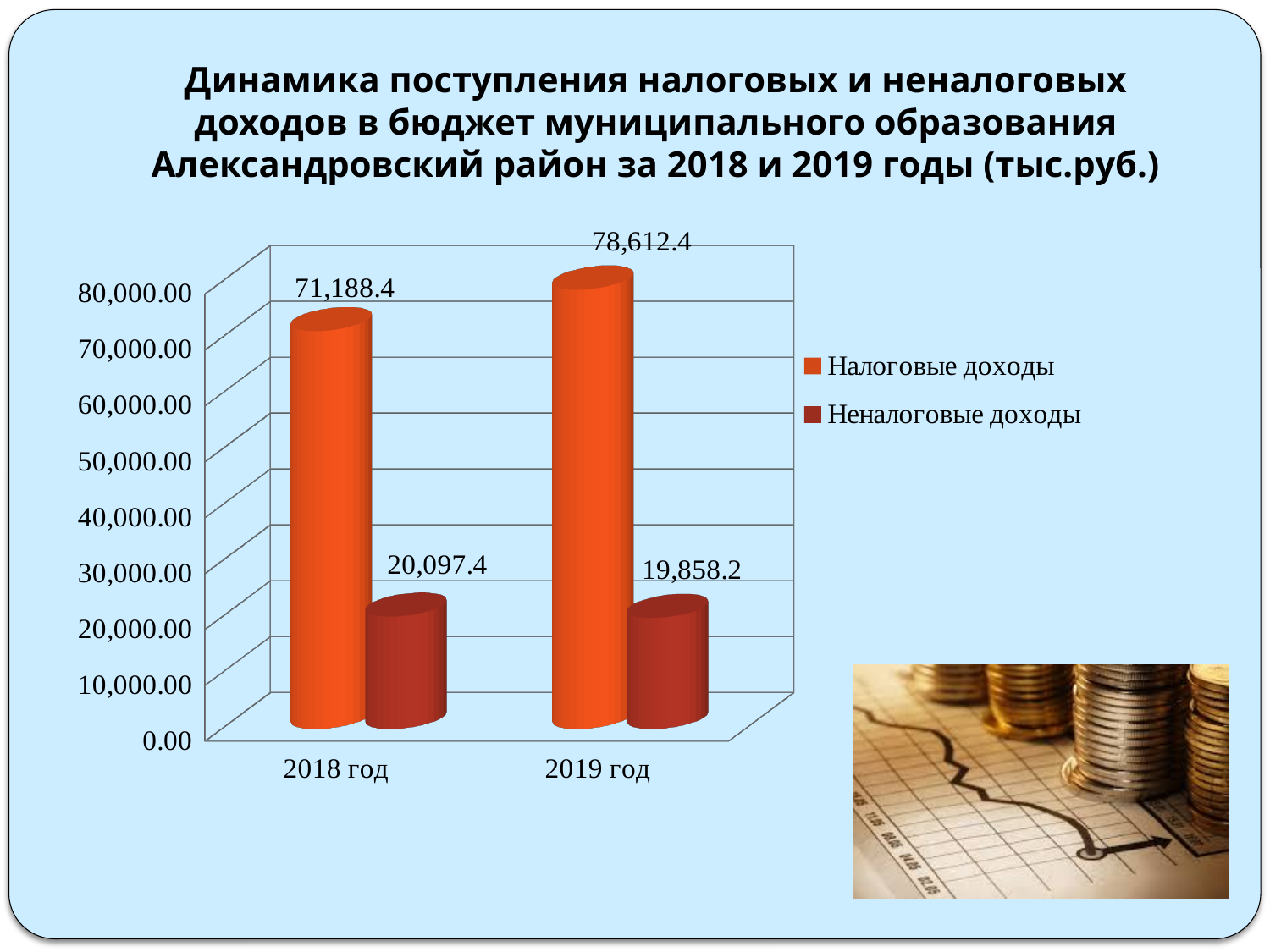
Is Налоговые доходы in 2018 год larger or smaller than Неналоговые доходы in 2018 год? larger What kind of chart is shown on the slide? bar chart What is the value of Неналоговые доходы for 2019 год? 19,858.2 Does Налоговые доходы rise or fall from 2018 год to 2019 год? rise Is the value for Налоговые доходы in 2019 год greater or less than 70,000.00? greater What is the value of Неналоговые доходы for 2018 год? 20,097.4 Which year has the lower value for Неналоговые доходы? 2019 год How many series does the legend list? 2 Which year has the higher value for Налоговые доходы? 2019 год What is the value of Налоговые доходы for 2018 год? 71,188.4 What is the value of Налоговые доходы for 2019 год? 78,612.4 What is the difference between Налоговые доходы in 2019 год and 2018 год? 7,424.0